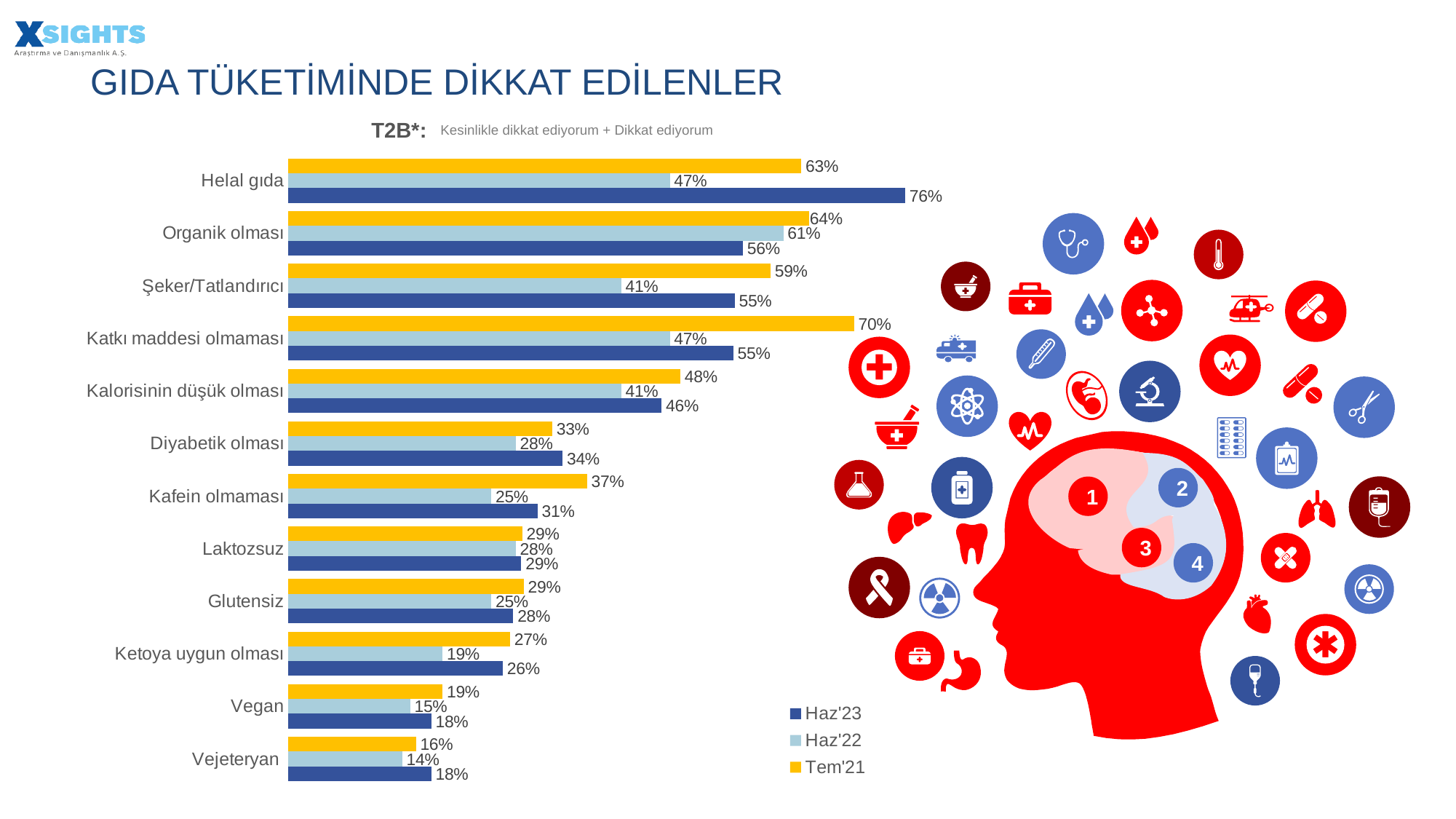
How many categories are shown on the chart? 12 What is the Haz'22 value for Organik olması? 61% What is the Haz'23 value for Helal gıda? 76% Which series is shown in yellow in the legend? Tem'21 How many series does the legend list? 3 What is the Haz'22 value for Vegan? 15% What is the Tem'21 value for Katkı maddesi olmaması? 70% What is the difference between the Haz'23 and Haz'22 values for Helal gıda? 29 percentage points What kind of chart is shown on the slide? Bar chart Which is larger for Organik olması: the Tem'21 value or the Haz'23 value? Tem'21 Which category has the highest Haz'23 value? Helal gıda Which category has the lowest Haz'22 value? Vejeteryan